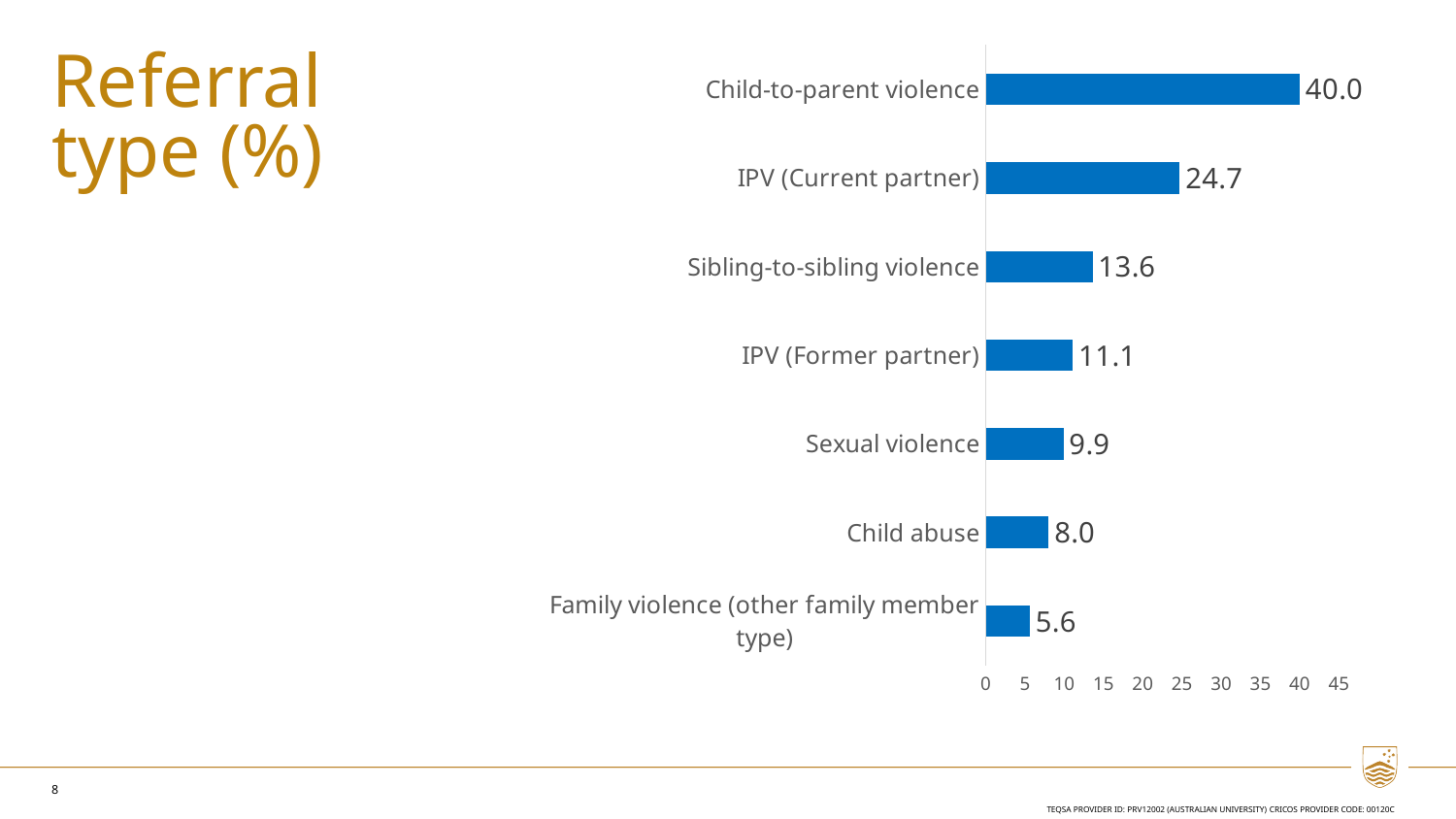
What kind of chart is shown on the slide? Bar chart Which is larger, the value for Child abuse or the value for Sexual violence? Sexual violence What is the difference between the values for Child-to-parent violence and IPV (Current partner)? 15.3 What is the value for Family violence (other family member type)? 5.6 Which referral type has the lowest value? Family violence (other family member type) Which referral type has the highest value? Child-to-parent violence What is the title of the slide? Referral type (%) What is the difference between the values for Sibling-to-sibling violence and IPV (Former partner)? 2.5 What is the value for IPV (Current partner)? 24.7 What is the value for Child-to-parent violence? 40.0 How many referral types are shown in the chart? 7 What is the value for Sexual violence? 9.9